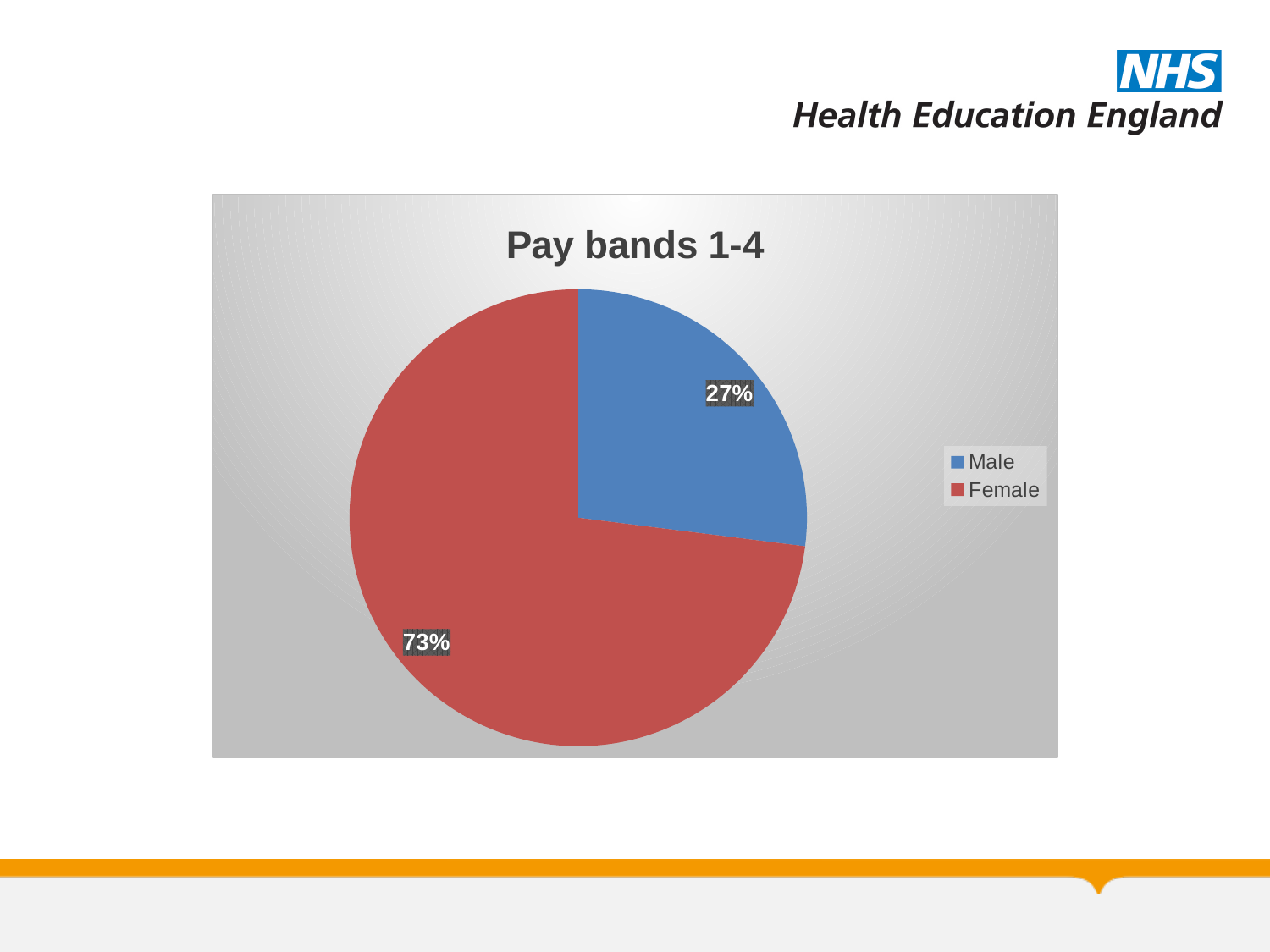
What colour is the Female slice? red What is the difference in percentage points between the Female share and the Male share? 46 What share of the pie does the Male slice represent? 27% Which category has the smallest share of the pie? Male What percentage of the pie is labelled for Male? 27% How many entries does the legend list? 2 How many slices does the pie chart have? 2 What kind of chart is shown on the slide? pie chart Which is larger, the Male share or the Female share? Female What is the title of the chart? Pay bands 1-4 Which category has the largest share of the pie? Female What percentage of the pie is labelled for Female? 73%